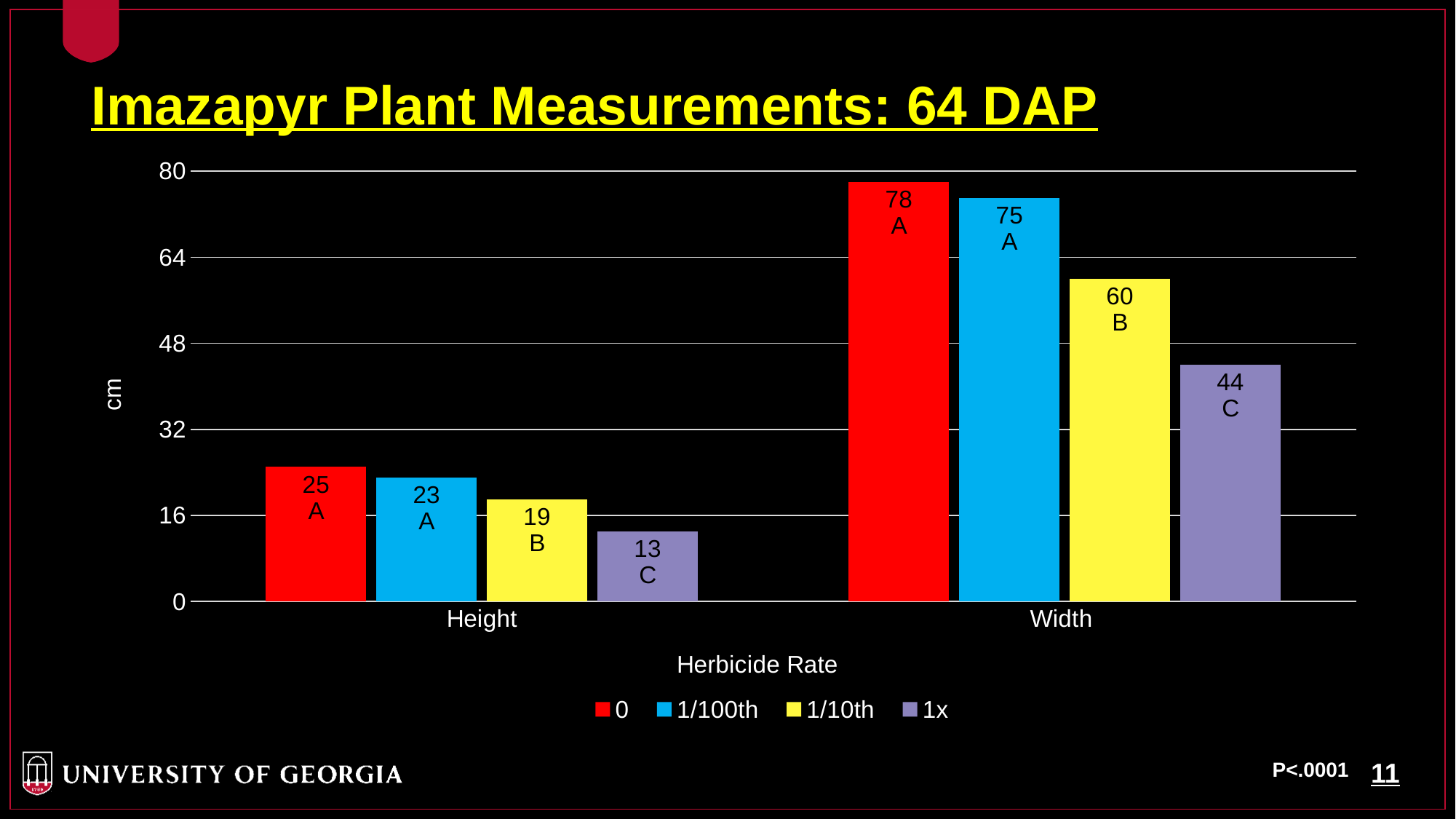
What is the difference between the Height values for the 1/100th and 1/10th herbicide rates? 4 What is the difference between the Width values for the 0 and 1x herbicide rates? 34 What is the label on the y axis? cm What is the Width value for the 1/10th herbicide rate? 60 What is the Height value for the 0 herbicide rate? 25 Which is larger: the Height value for 1/100th or the Height value for 1x? 1/100th What is the Width value for the 1x herbicide rate? 44 What kind of chart is shown on the slide? Bar chart How many categories are shown on the x axis? 2 Which herbicide rate has the lowest Height value? 1x How many series does the legend list? 4 Which herbicide rate has the highest Width value? 0